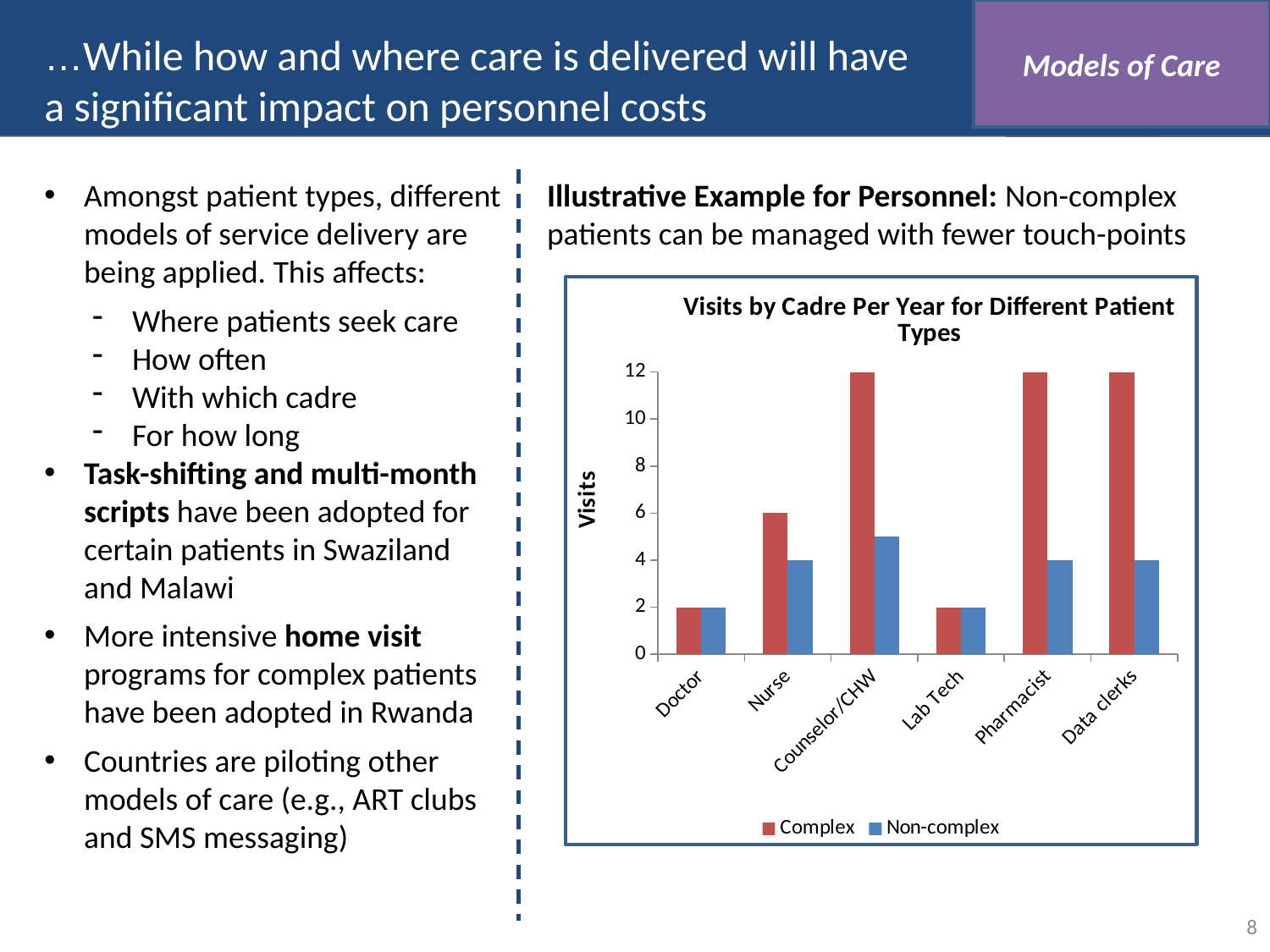
How many series does the legend of the chart list? 2 For Nurse, which patient type has more visits per year, Complex or Non-complex? Complex How many cadres are shown on the x axis of the chart? 6 How many visits per year does the chart show for Non-complex patients with a Pharmacist? 4 What is the title of the chart? Visits by Cadre Per Year for Different Patient Types Is the value for Non-complex patients with a Counselor/CHW greater or less than 4? greater How many visits per year does the chart show for Complex patients with a Doctor? 2 Which colour represents the Complex series in the chart? Red What type of chart is shown on the slide? Bar chart How many visits per year does the chart show for Complex patients with a Nurse? 6 What is the difference in visits per year between Complex and Non-complex patients for Nurse? 2 Is the value for Complex patients with a Counselor/CHW greater or less than 10? greater